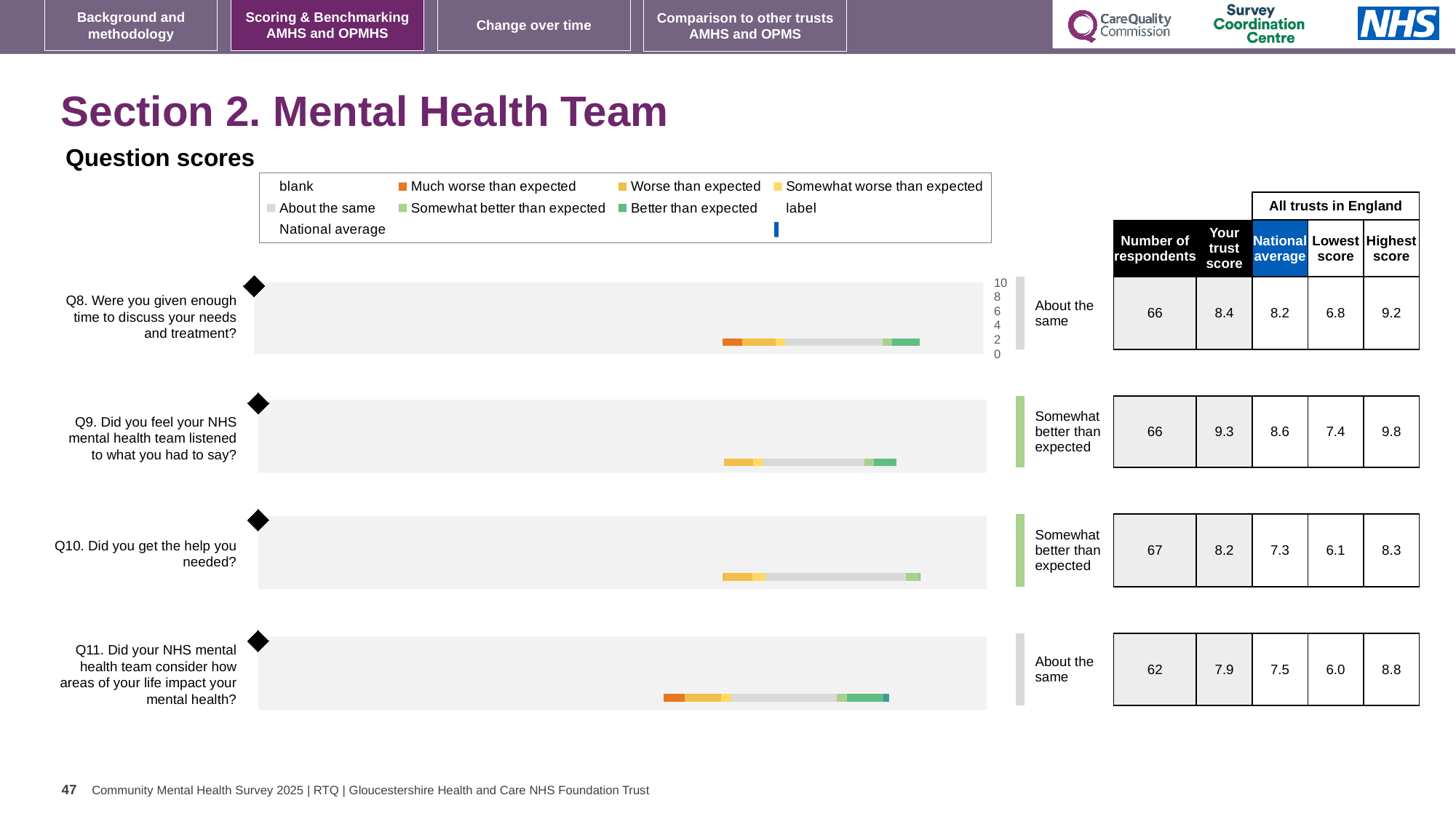
Is the trust score for Q8 greater or less than 8? greater What is the highest score among all trusts in England for Q10 (Did you get the help you needed)? 8.3 How many questions (Q8 to Q11) have a score chart on the slide? 4 For Q10, which is larger: the trust score or the national average? the trust score What kind of chart is used to show the question scores for Q8 to Q11? bar chart Which question has the highest trust score? Q9 What is the trust score for Q8 (Were you given enough time to discuss your needs and treatment)? 8.4 How many respondents answered Q11 (Did your NHS mental health team consider how areas of your life impact your mental health)? 62 What is the national average score for Q9 (Did you feel your NHS mental health team listened to what you had to say)? 8.6 What is the difference between the trust score and the national average for Q9? 0.7 Which question has the lowest trust score? Q11 What benchmark category is shown next to the chart for Q10 (Did you get the help you needed)? Somewhat better than expected